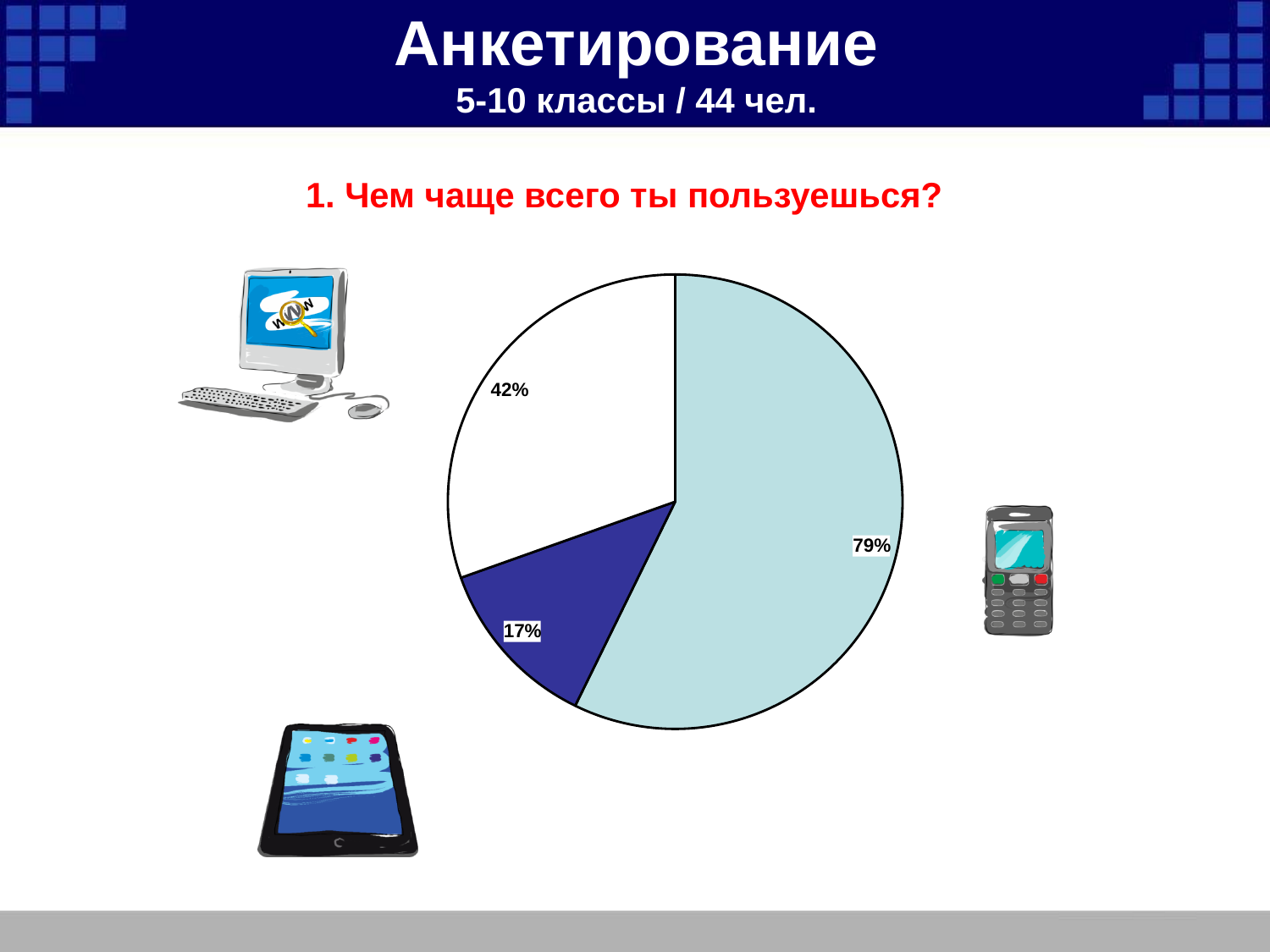
What kind of chart is shown on the slide? pie chart Which slice is larger, the white slice or the dark blue slice? the white slice What is the smallest value shown on the pie chart? 17% How many slices does the pie chart have? 3 What value is labelled on the dark blue slice of the pie chart? 17% What question is the pie chart answering, according to the red heading above it? 1. Чем чаще всего ты пользуешься? What value is labelled on the light blue slice of the pie chart? 79% How many people took part in the survey, according to the slide header? 44 чел. What is the largest value shown on the pie chart? 79% What is the difference between the white slice (42%) and the dark blue slice (17%)? 25% What value is labelled on the white slice of the pie chart? 42% What is the difference between the largest slice (79%) and the white slice (42%)? 37%